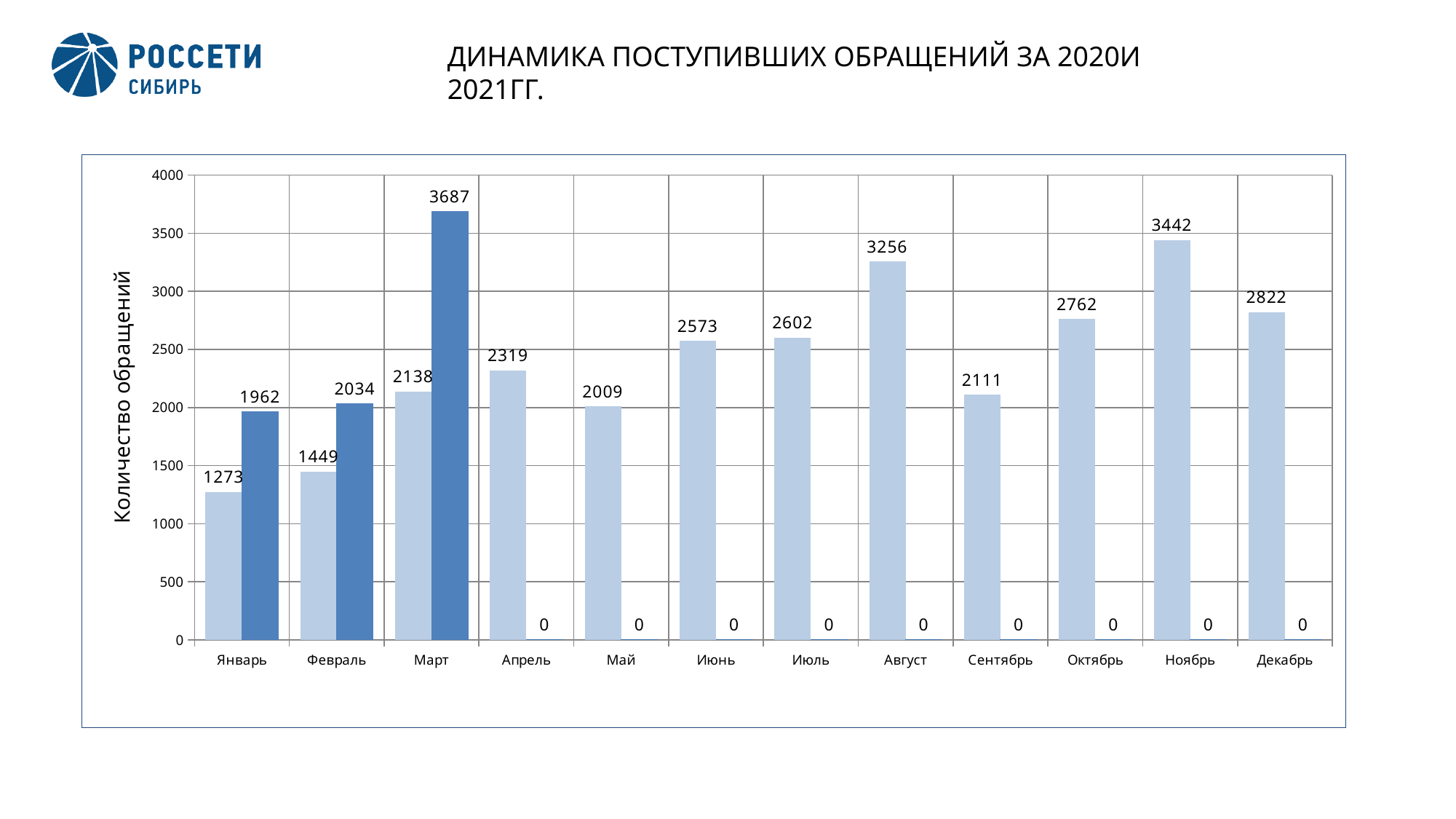
What is the value of the light blue bar for Ноябрь? 3442 What is the value of the dark blue bar for Март? 3687 For Март, what is the difference between the dark blue bar and the light blue bar? 1549 Among the light blue bars, which month has the lowest value? Январь For Январь, what is the difference between the dark blue bar and the light blue bar? 689 Among the light blue bars, which month has the highest value? Ноябрь Do the light blue bars rise or fall from Январь to Март? Rise What is the title of the vertical axis? Количество обращений What is the value of the dark blue bar for Апрель? 0 Which light blue bar is larger, Август or Декабрь? Август What kind of chart is shown on the slide? Bar chart How many months are shown on the x axis? 12